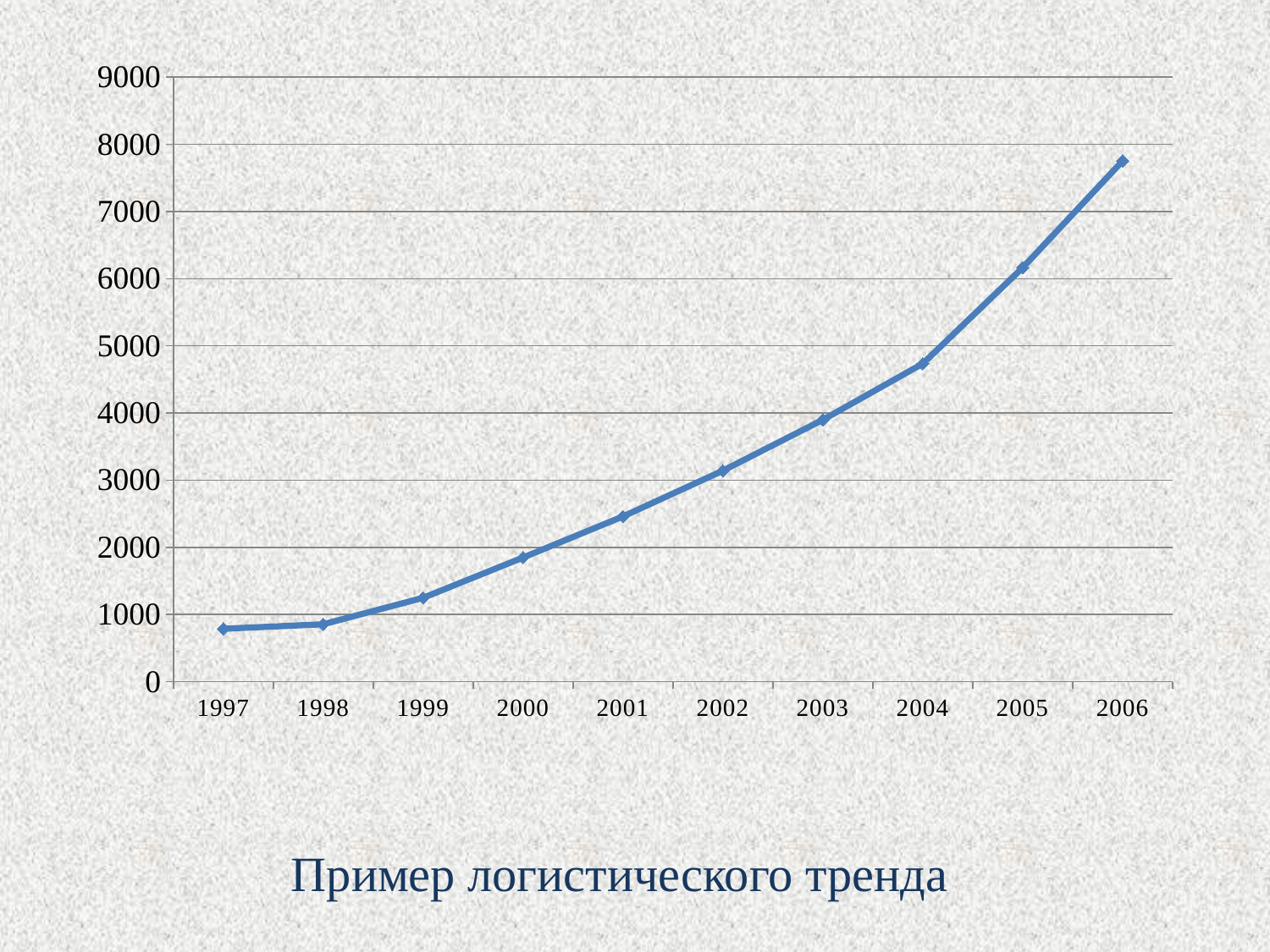
Is the value for 2006 greater or less than 7000? greater Which year has the lowest value on the chart? 1997 How many data points are plotted on the chart? 10 Is the value for 1997 greater or less than 1000? less Is the value for 2003 greater or less than 3000? greater Do the values rise or fall from 1997 to 2006? rise What is the first year shown on the x axis? 1997 What kind of chart is shown on the slide? line chart Which is larger, the value for 2005 or the value for 2004? 2005 What is the caption written below the chart? Пример логистического тренда Which year has the highest value on the chart? 2006